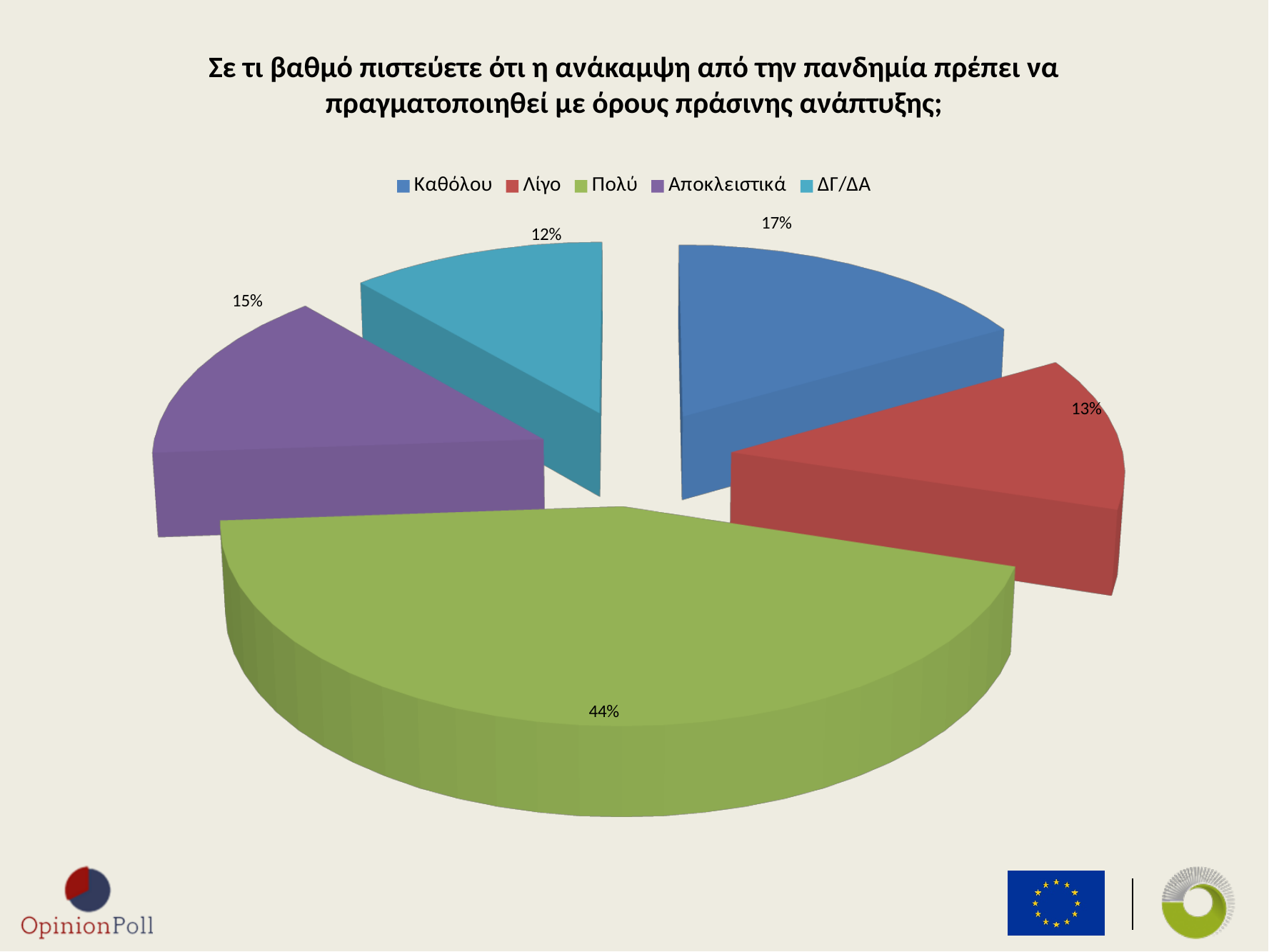
How many categories does the legend list? 5 What percentage of respondents answered Πολύ? 44% What kind of chart is shown on the slide? Pie chart What percentage of respondents answered Αποκλειστικά? 15% What colour is the slice for Πολύ? Green What is the difference in percentage points between Πολύ and Καθόλου? 27 What percentage of respondents answered ΔΓ/ΔΑ? 12% Which response category has the smallest share of the pie? ΔΓ/ΔΑ What percentage of respondents answered Καθόλου? 17% Which is larger, the share for Αποκλειστικά or the share for Λίγο? Αποκλειστικά Which response category has the largest share of the pie? Πολύ What percentage of respondents answered Λίγο? 13%